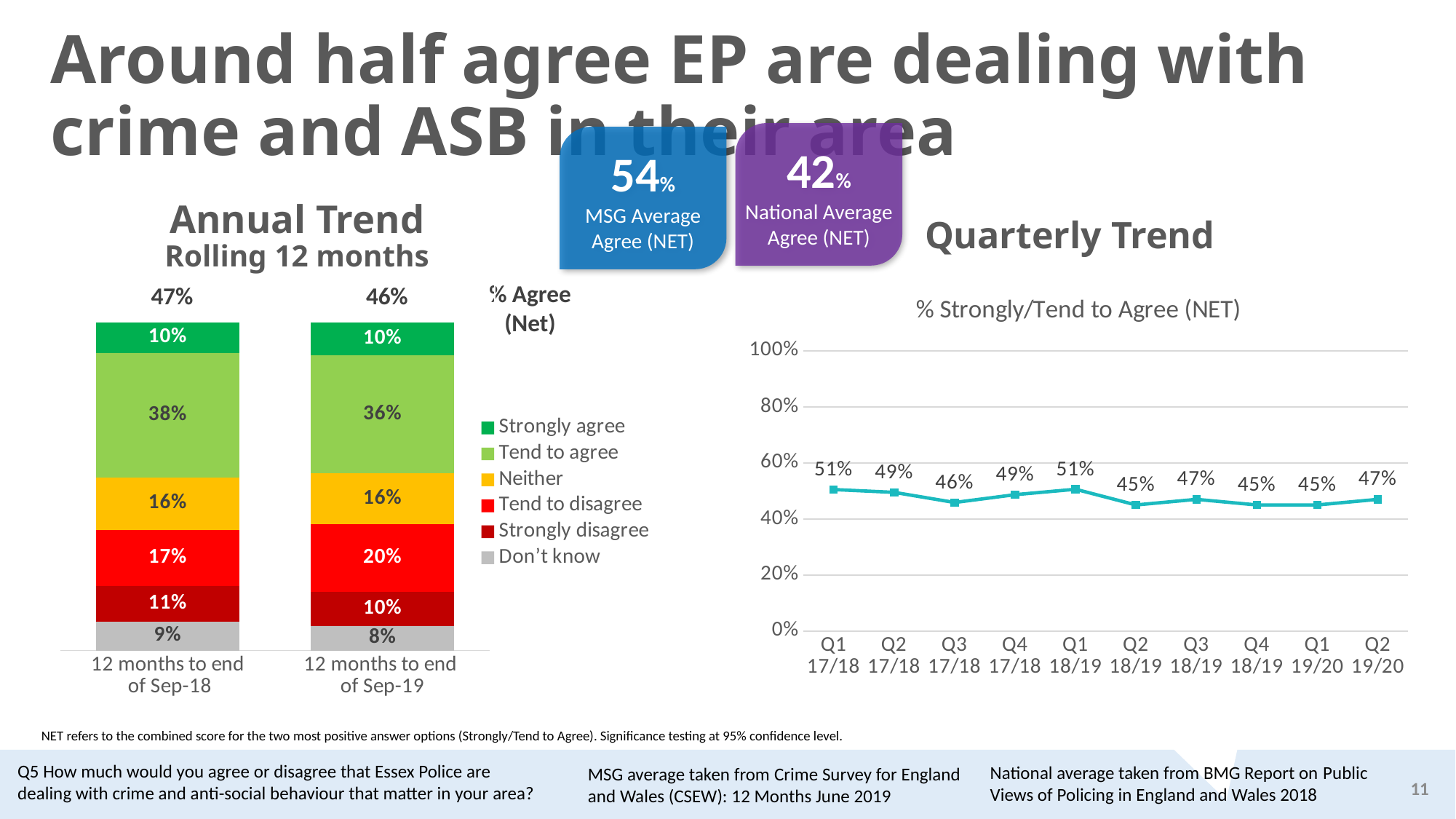
In the Quarterly Trend chart, how many quarters are plotted? 10 In the Annual Trend chart, how many series does the legend list? 6 In the Quarterly Trend chart, what is the value for Q2 19/20? 47% In the Quarterly Trend chart, what is the difference between the values for Q1 18/19 and Q2 18/19? 6% In the Annual Trend chart, what is the % Agree (Net) for the 12 months to end of Sep-18? 47% In the Quarterly Trend chart, what is the value for Q3 17/18? 46% In the Annual Trend chart, what is the difference in the 'Tend to agree' share between the 12 months to end of Sep-18 and the 12 months to end of Sep-19? 2% What kind of chart is the Annual Trend chart? Stacked bar chart In the Annual Trend chart, which period has the larger 'Tend to disagree' share: 12 months to end of Sep-18 or 12 months to end of Sep-19? 12 months to end of Sep-19 In the Annual Trend chart, what percentage said 'Tend to disagree' in the 12 months to end of Sep-18? 17% In the Annual Trend chart, what percentage said 'Tend to agree' in the 12 months to end of Sep-19? 36% What kind of chart is the Quarterly Trend chart? Line chart